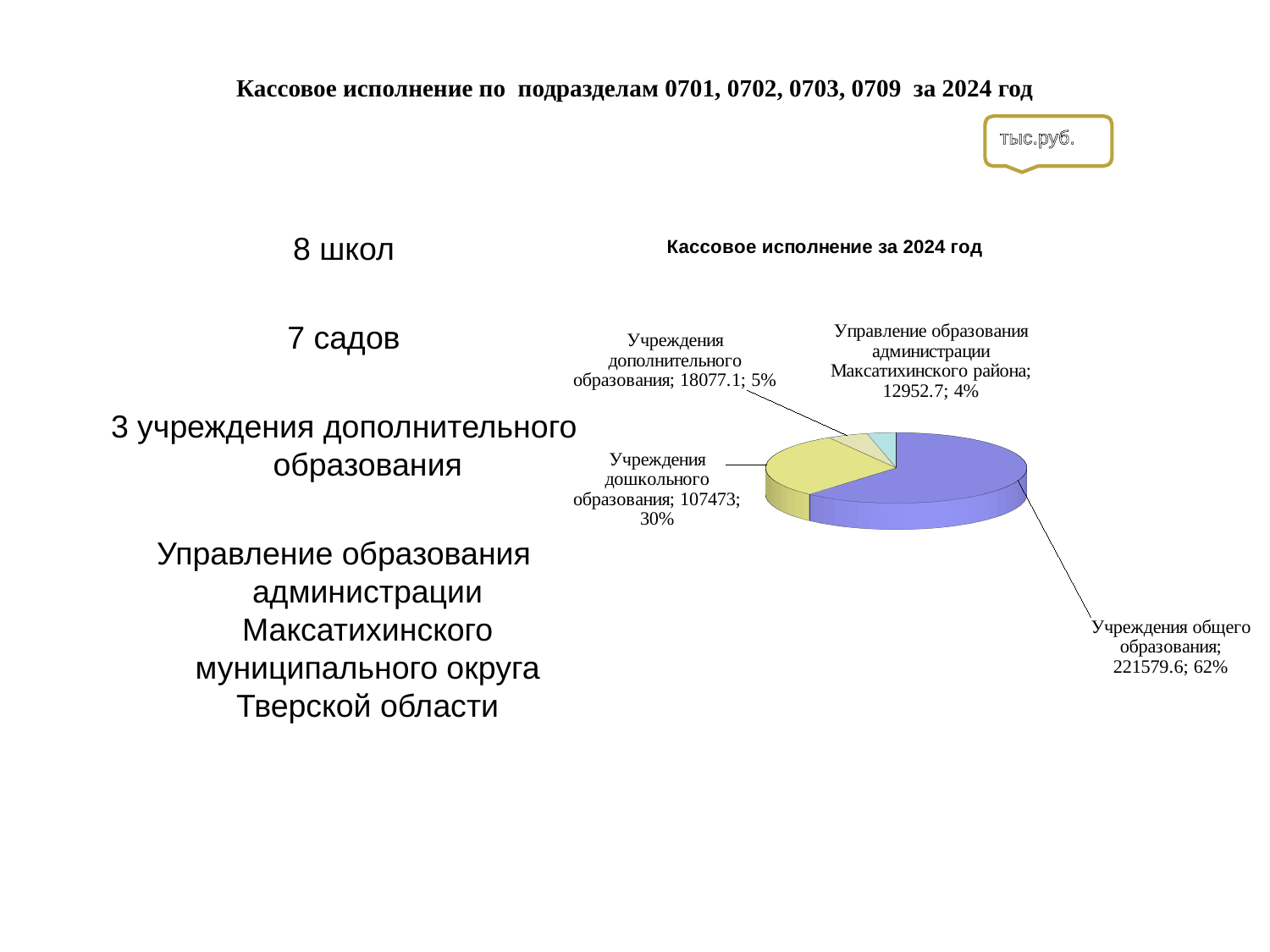
How many slices does the pie chart have? 4 What share of the pie does Учреждения дошкольного образования take? 30% What is the chart's title? Кассовое исполнение за 2024 год What is the value for Учреждения дополнительного образования? 18077.1 Which category has the smallest slice? Управление образования администрации Максатихинского района What is the value for Управление образования администрации Максатихинского района? 12952.7 What is the value for Учреждения дошкольного образования? 107473 Which category has the largest slice? Учреждения общего образования What is the difference between the values for Учреждения дополнительного образования and Управление образования администрации Максатихинского района? 5124.4 What kind of chart is shown on the slide? pie chart What is the value for Учреждения общего образования? 221579.6 What share of the pie does Учреждения общего образования take? 62%